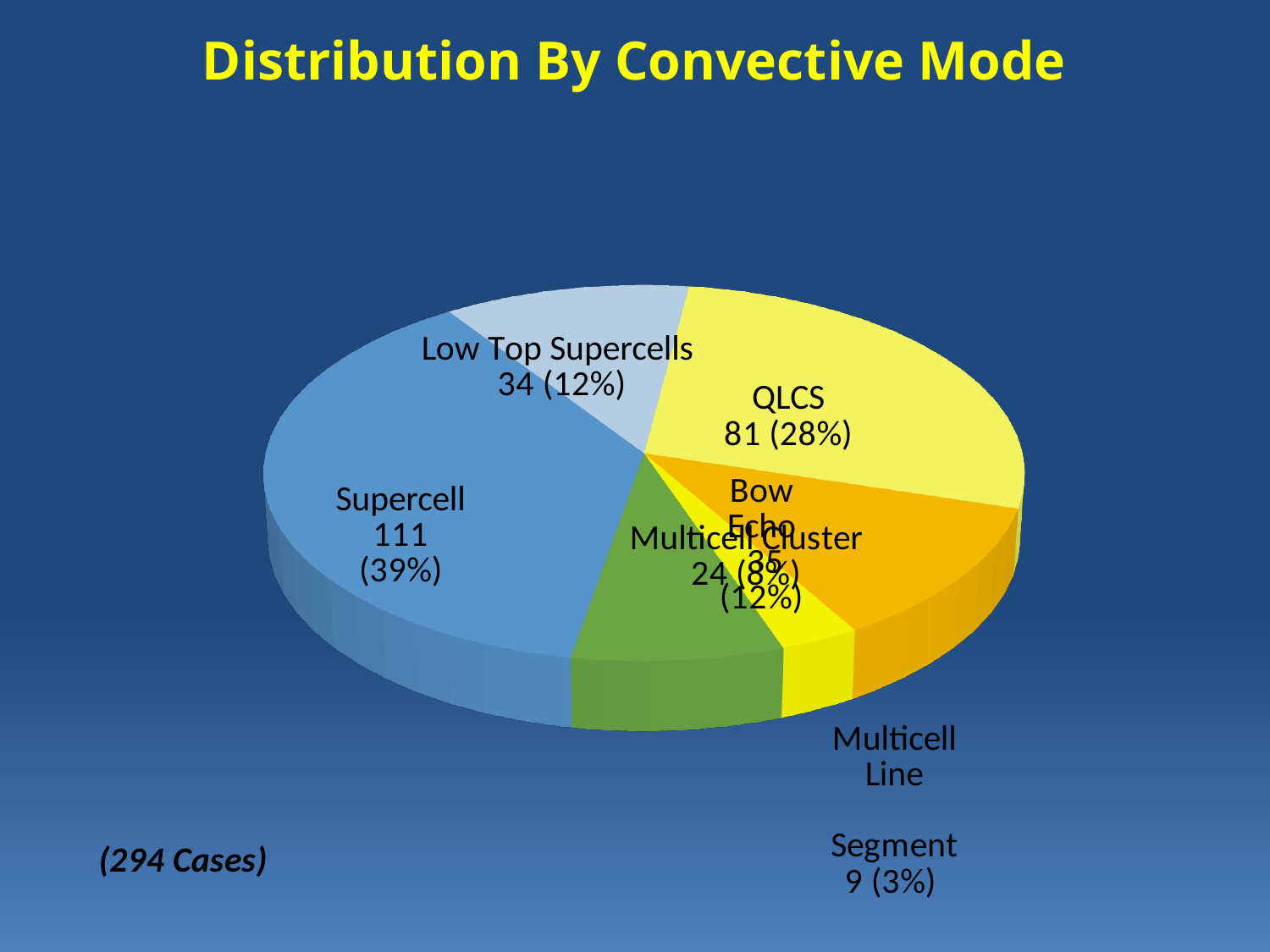
How many cases does the Low Top Supercells slice represent? 34 What percentage of cases does the QLCS slice account for? 28% How many convective mode categories are shown in the pie chart? 6 How many more cases are in the Supercell category than in the QLCS category? 30 How many total cases does the chart cover, according to the slide? 294 Cases What kind of chart is shown on the slide? Pie chart How many cases does the Multicell Line Segment slice represent? 9 How many cases does the QLCS slice represent? 81 How many cases does the Supercell slice represent? 111 What is the title of the chart? Distribution By Convective Mode Which convective mode has the smallest share of cases? Multicell Line Segment Which convective mode has the largest share of cases? Supercell